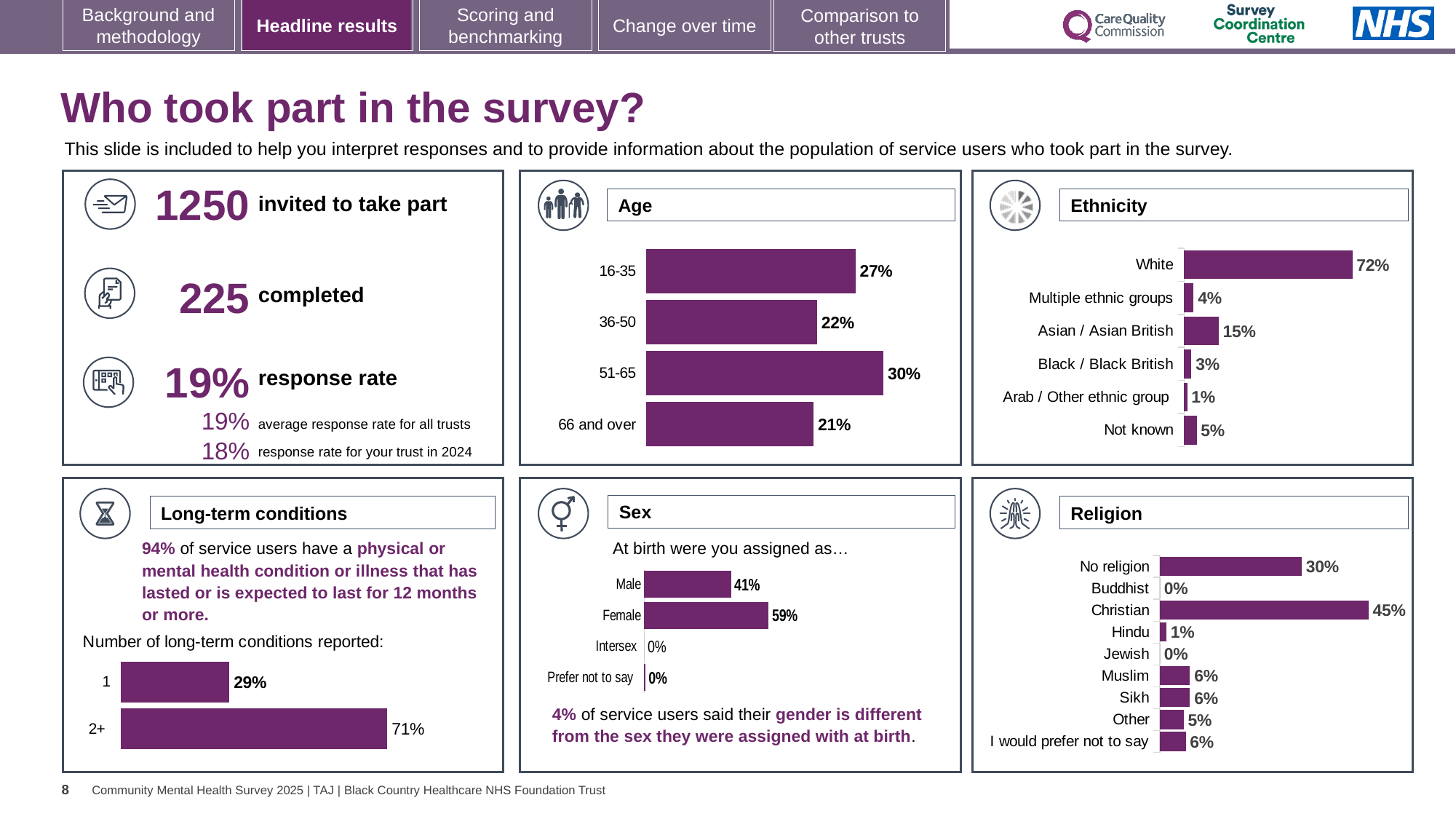
In the Religion chart, what is the difference between the Christian and No religion percentages? 15% In the Sex chart, what percentage of respondents answered Prefer not to say? 0% In the Ethnicity chart, what percentage of respondents were Asian / Asian British? 15% What type of chart is used in the Age panel? Bar chart How many categories are shown in the Ethnicity chart? 6 In the Religion chart, which religion category has the highest percentage? Christian In the Long-term conditions chart, what percentage of service users reported 2+ long-term conditions? 71% In the Age chart, which age group has the lowest percentage? 66 and over In the Age chart, what is the difference between the 16-35 and 36-50 percentages? 5% In the Age chart, what percentage of respondents were aged 51-65? 30% In the Ethnicity chart, which category has the highest percentage? White In the Sex chart, which is larger, the Male or the Female percentage? Female